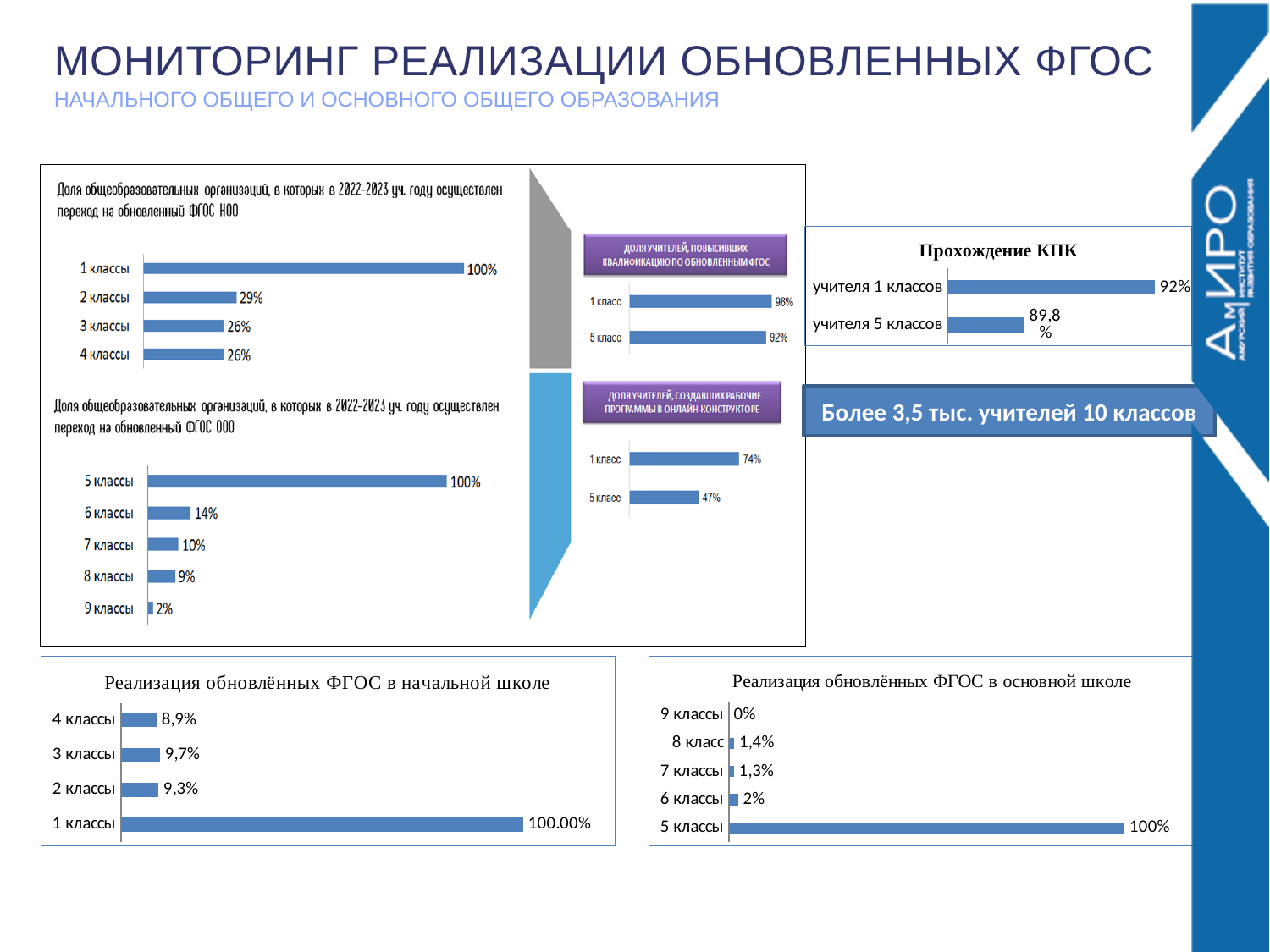
In the chart 'Реализация обновлённых ФГОС в основной школе', what is the value for 8 класс? 1,4% In the chart 'Доля общеобразовательных организаций, в которых в 2022-2023 уч. году осуществлен переход на обновленный ФГОС ООО', which category has the lowest value? 9 классы In the chart 'Доля учителей, создавших рабочие программы в онлайн-конструкторе', what is the difference between 1 класс and 5 класс? 27% In the chart 'Доля общеобразовательных организаций, в которых в 2022-2023 уч. году осуществлен переход на обновленный ФГОС ООО', how many categories are shown? 5 In the chart 'Доля учителей, повысивших квалификацию по обновленным ФГОС', what is the value for 5 класс? 92% What type of chart is 'Реализация обновлённых ФГОС в основной школе'? Bar chart In the chart 'Прохождение КПК', what is the value for учителя 5 классов? 89,8% In the chart 'Реализация обновлённых ФГОС в начальной школе', what is the value for 3 классы? 9,7% In the chart 'Доля общеобразовательных организаций, в которых в 2022-2023 уч. году осуществлен переход на обновленный ФГОС НОО', what is the value for 2 классы? 29% In the chart 'Доля общеобразовательных организаций, в которых в 2022-2023 уч. году осуществлен переход на обновленный ФГОС ООО', what is the difference between 6 классы and 7 классы? 4% In the chart 'Реализация обновлённых ФГОС в начальной школе', which category has the highest value? 1 классы In the chart 'Доля учителей, создавших рабочие программы в онлайн-конструкторе', which is larger, 1 класс or 5 класс? 1 класс